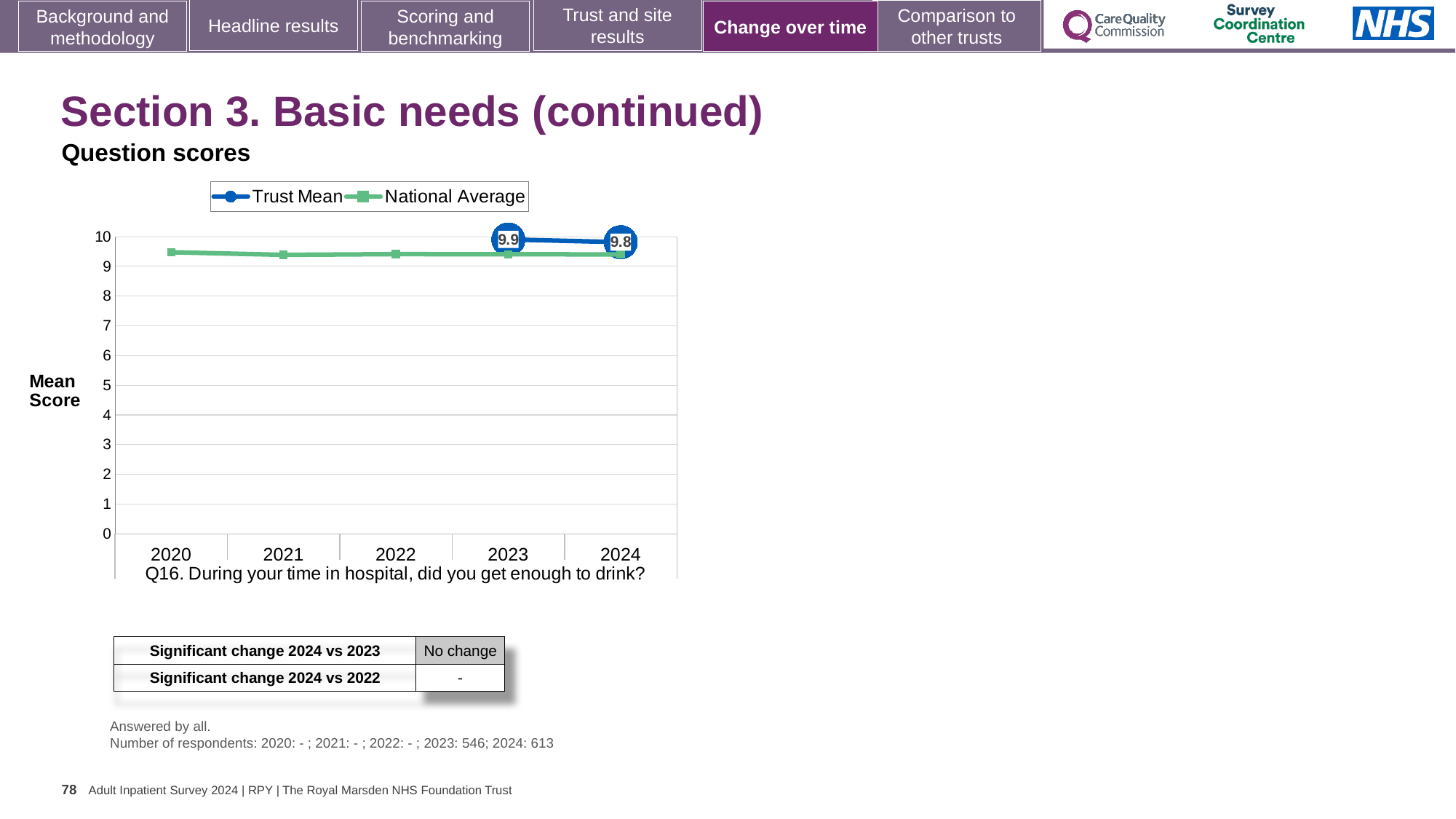
Is the National Average value for 2020 greater or less than 9? greater What is the difference between the Trust Mean in 2023 and in 2024? 0.1 How many data points are plotted for the Trust Mean series? 2 Which year has the higher Trust Mean, 2023 or 2024? 2023 How many series does the legend list? 2 Is the National Average value for 2022 greater or less than 10? less How many years are shown on the x axis of the chart? 5 Does the Trust Mean rise or fall from 2023 to 2024? Fall What kind of chart is shown on the slide? Line chart What is the Trust Mean value for 2023? 9.9 What is the Trust Mean value for 2024? 9.8 In 2024, which series has the higher value, Trust Mean or National Average? Trust Mean